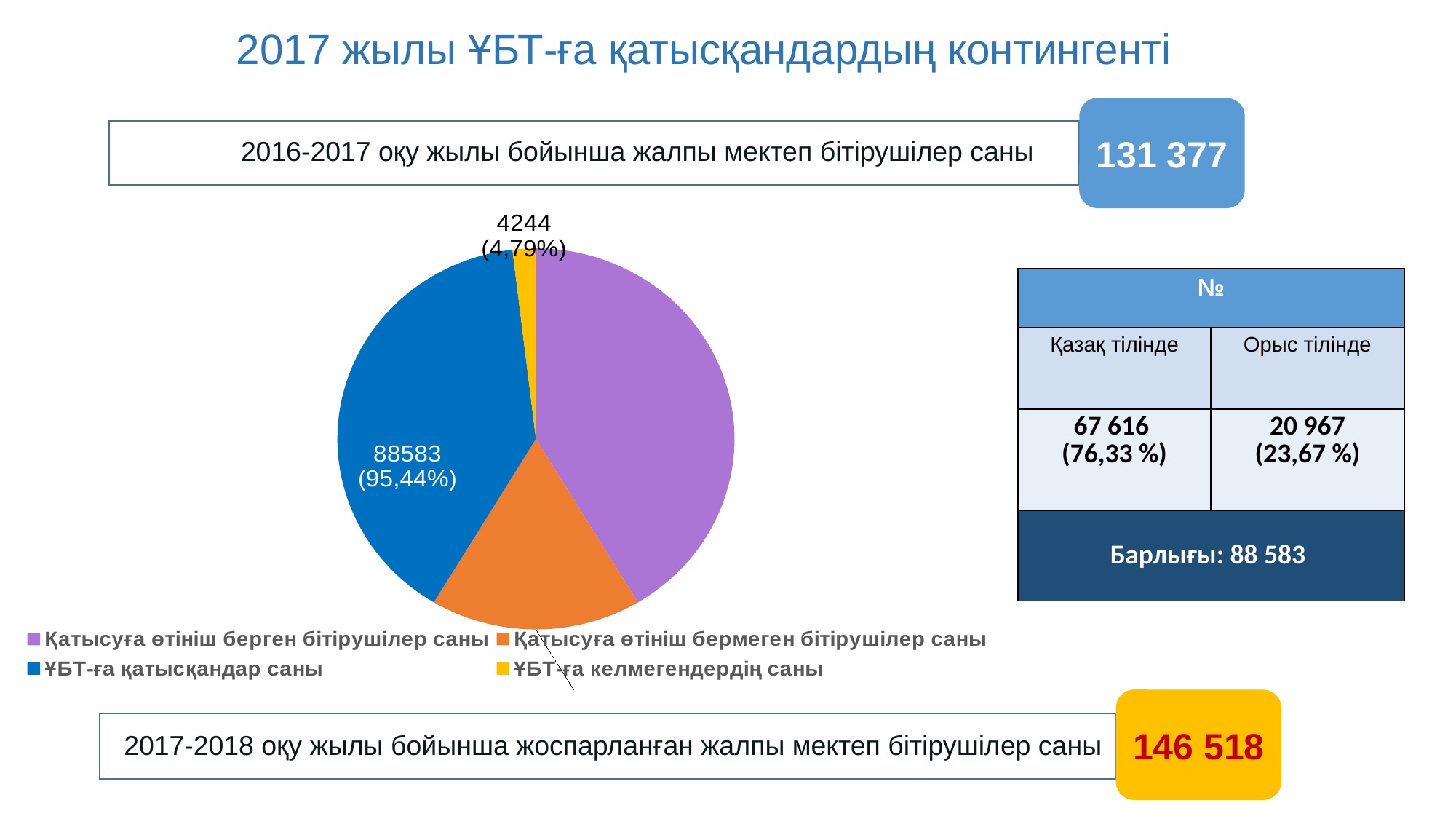
How many entries does the legend of the pie chart list? 4 What value is labelled on the slice for "ҰБТ-ға қатысқандар саны"? 88583 What value is labelled on the slice for "ҰБТ-ға келмегендердің саны"? 4244 Which slice of the pie chart is the smallest? ҰБТ-ға келмегендердің саны How many slices does the pie chart have? 4 What is the title of the slide containing the pie chart? 2017 жылы ҰБТ-ға қатысқандардың контингенті What percentage share is printed for the "ҰБТ-ға келмегендердің саны" slice? 4,79% What is the difference between the labelled values for "ҰБТ-ға қатысқандар саны" and "ҰБТ-ға келмегендердің саны"? 84339 What colour is the slice for "Қатысуға өтініш бермеген бітірушілер саны"? orange What kind of chart is shown on the slide? pie chart Which is larger: "ҰБТ-ға қатысқандар саны" or "ҰБТ-ға келмегендердің саны"? ҰБТ-ға қатысқандар саны What percentage share is printed for the "ҰБТ-ға қатысқандар саны" slice? 95,44%